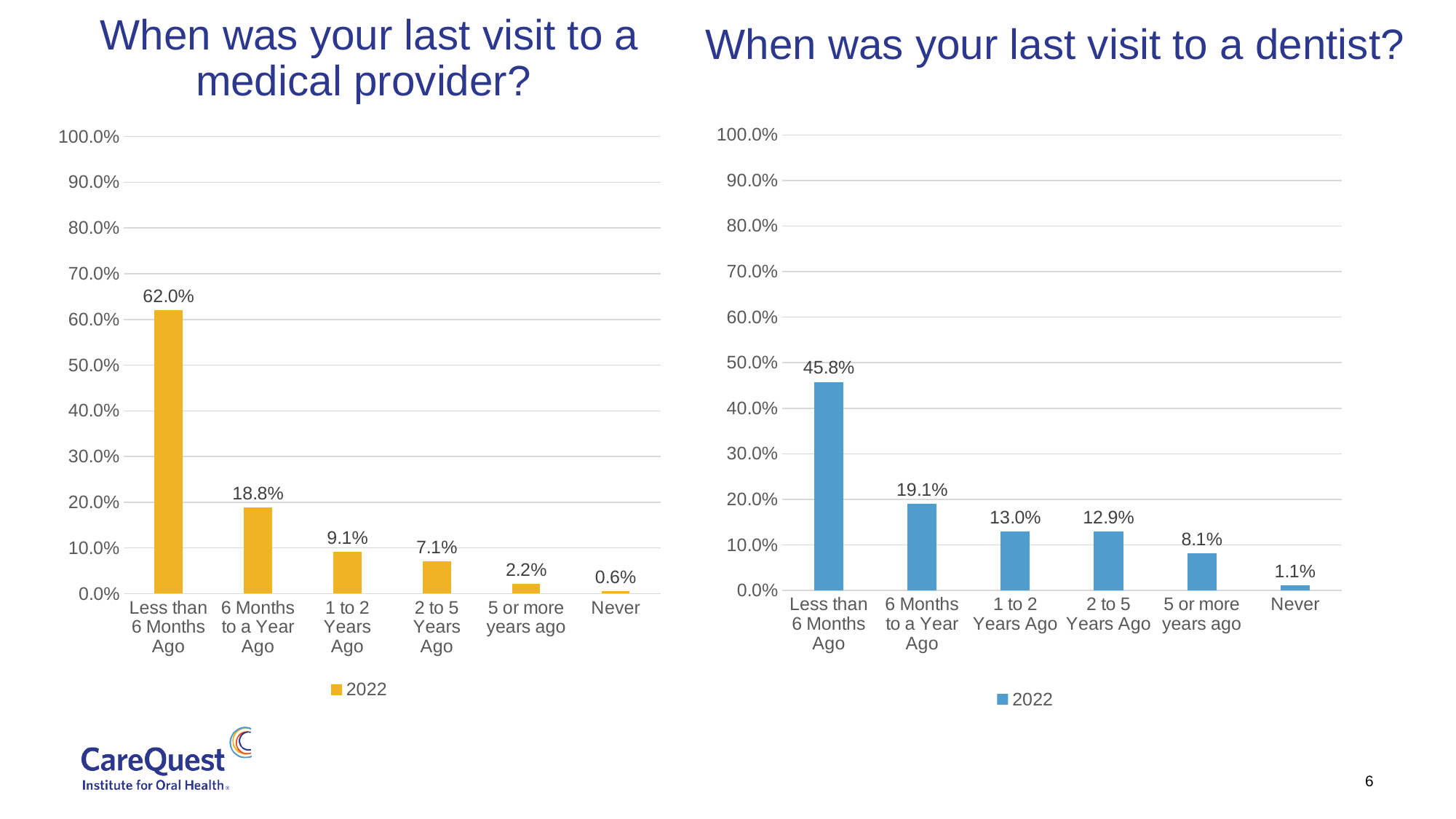
In the 'When was your last visit to a dentist?' chart, what is the value for 'Never'? 1.1% How many series does the legend list in the 'When was your last visit to a medical provider?' chart? 1 What type of chart is the 'When was your last visit to a dentist?' chart? Bar chart In the 'When was your last visit to a medical provider?' chart, is the value for 'Less than 6 Months Ago' greater or less than 50.0%? greater How many categories are shown in the 'When was your last visit to a dentist?' chart? 6 In the 'When was your last visit to a medical provider?' chart, which category has the lowest value? Never Which is larger: the 'Less than 6 Months Ago' value in the medical provider chart or the 'Less than 6 Months Ago' value in the dentist chart? Medical provider chart In the 'When was your last visit to a dentist?' chart, what is the value for '6 Months to a Year Ago'? 19.1% In the 'When was your last visit to a medical provider?' chart, what is the value for 'Less than 6 Months Ago'? 62.0% In the 'When was your last visit to a medical provider?' chart, what is the difference between '6 Months to a Year Ago' and '1 to 2 Years Ago'? 9.7% In the 'When was your last visit to a dentist?' chart, what is the difference between 'Less than 6 Months Ago' and '6 Months to a Year Ago'? 26.7% In the 'When was your last visit to a dentist?' chart, which category has the highest value? Less than 6 Months Ago